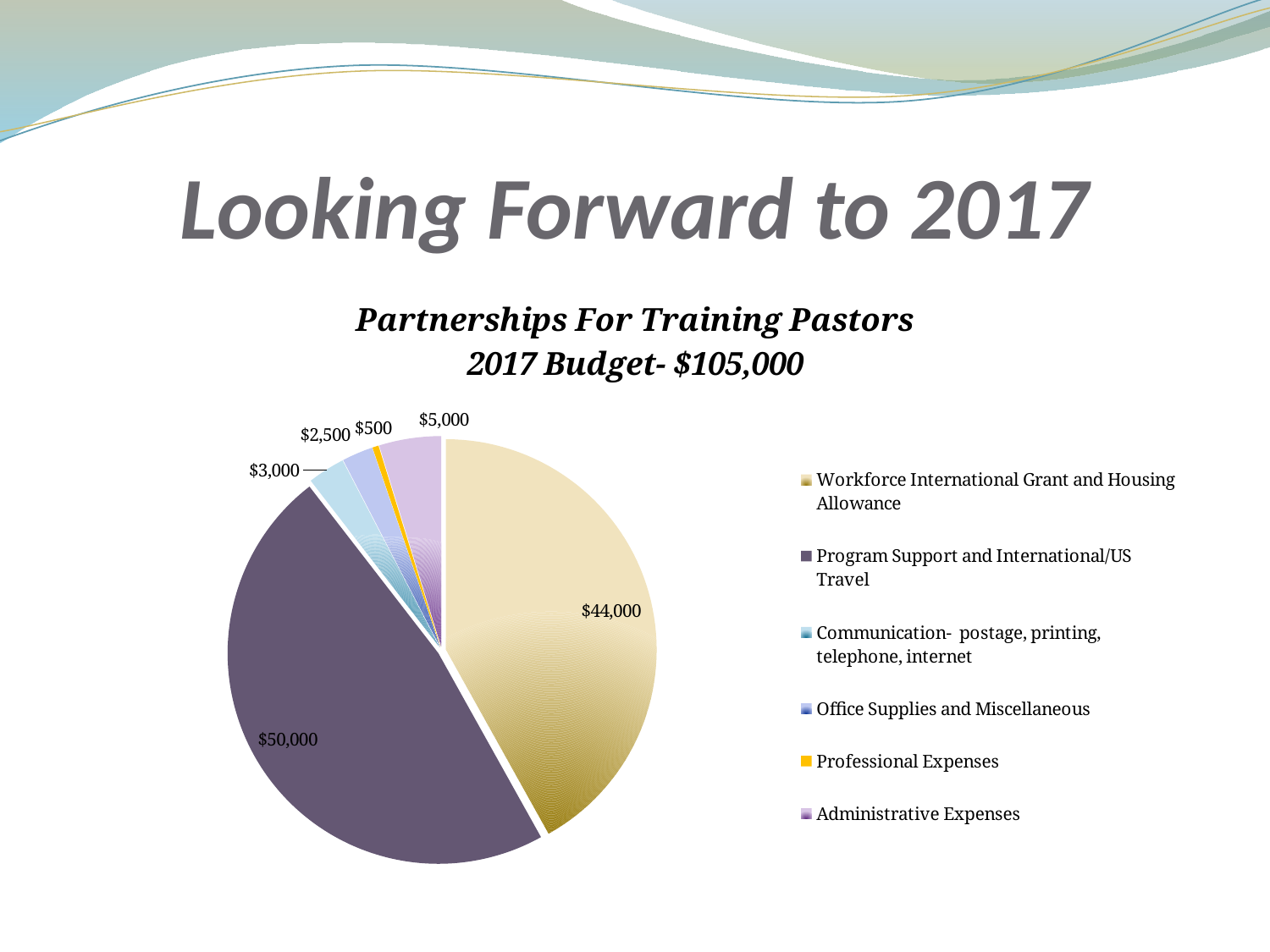
What is the value for Workforce International Grant and Housing Allowance? $44,000 What is the total budget stated in the chart title? $105,000 What kind of chart is shown on the slide? pie chart Which is larger, Administrative Expenses or Office Supplies and Miscellaneous? Administrative Expenses Which category has the largest slice of the pie? Program Support and International/US Travel How many categories does the legend list? 6 What is the value for Professional Expenses? $500 What is the difference between Program Support and International/US Travel and Workforce International Grant and Housing Allowance? $6,000 What is the value for Communication- postage, printing, telephone, internet? $3,000 What is the value for Program Support and International/US Travel? $50,000 What is the value for Administrative Expenses? $5,000 Which category has the smallest slice of the pie? Professional Expenses